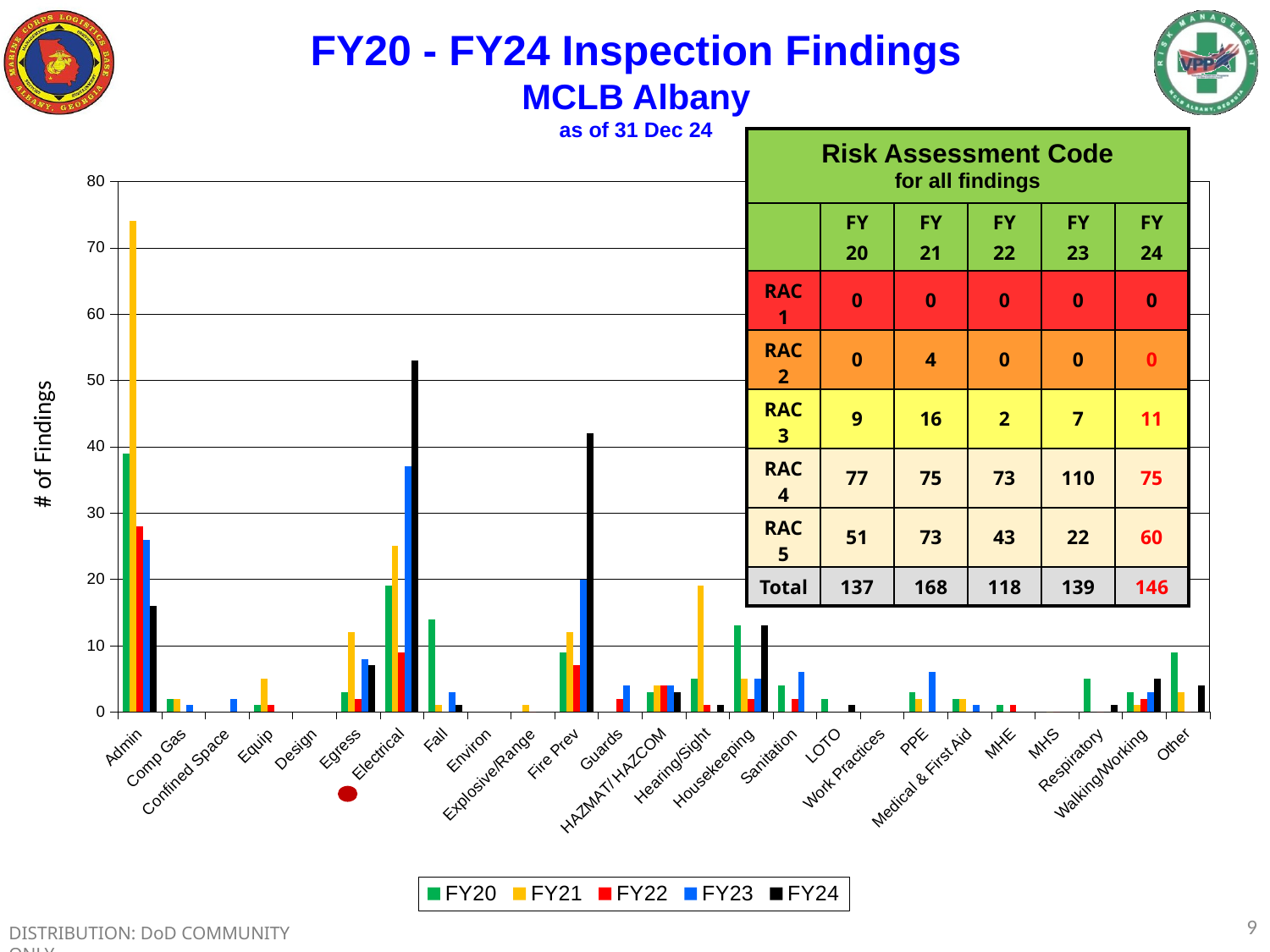
Is the FY23 value for Electrical greater or less than 30? greater How many series does the chart legend list? 5 Is the FY24 value for Electrical greater or less than 50? greater How many categories are shown along the x axis of the chart? 25 Which is larger, the FY24 value for Electrical or the FY24 value for Fire Prev? Electrical Which series has the tallest bar in the Fire Prev category? FY24 What kind of chart is shown on the slide? bar chart Which series has the tallest bar in the Admin category? FY21 Is the FY24 value for Fire Prev greater or less than 40? greater What is the label on the chart's vertical axis? # of Findings Which series has the tallest bar in the Electrical category? FY24